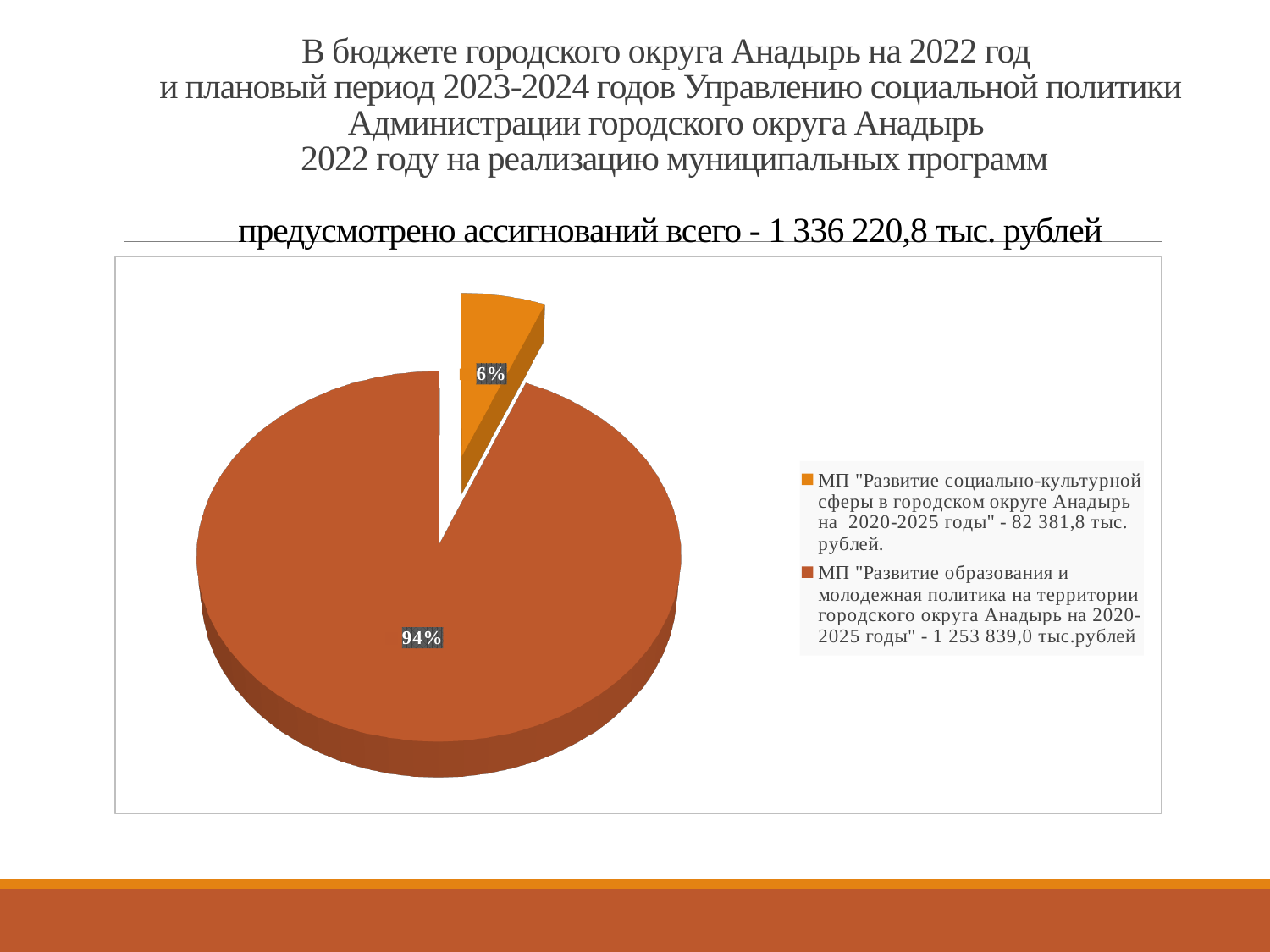
Which program has the smallest slice of the pie? МП "Развитие социально-культурной сферы в городском округе Анадырь на 2020-2025 годы" According to the legend, what amount is allocated to МП "Развитие образования и молодежная политика на территории городского округа Анадырь на 2020-2025 годы"? 1 253 839,0 тыс.рублей How many entries does the legend list? 2 What share of the pie does the МП "Развитие образования и молодежная политика на территории городского округа Анадырь на 2020-2025 годы" slice represent? 94% According to the legend, what amount is allocated to МП "Развитие социально-культурной сферы в городском округе Анадырь на 2020-2025 годы"? 82 381,8 тыс. рублей Which program has the largest slice of the pie? МП "Развитие образования и молодежная политика на территории городского округа Анадырь на 2020-2025 годы" Which slice is larger: the one for МП "Развитие социально-культурной сферы" or the one for МП "Развитие образования и молодежная политика"? МП "Развитие образования и молодежная политика" What is the difference in percentage points between the 94% slice and the 6% slice? 88 percentage points How many slices does the pie chart have? 2 What colour is the slice labelled 6%? orange What share of the pie does the МП "Развитие социально-культурной сферы в городском округе Анадырь на 2020-2025 годы" slice represent? 6% What kind of chart is shown on the slide? pie chart